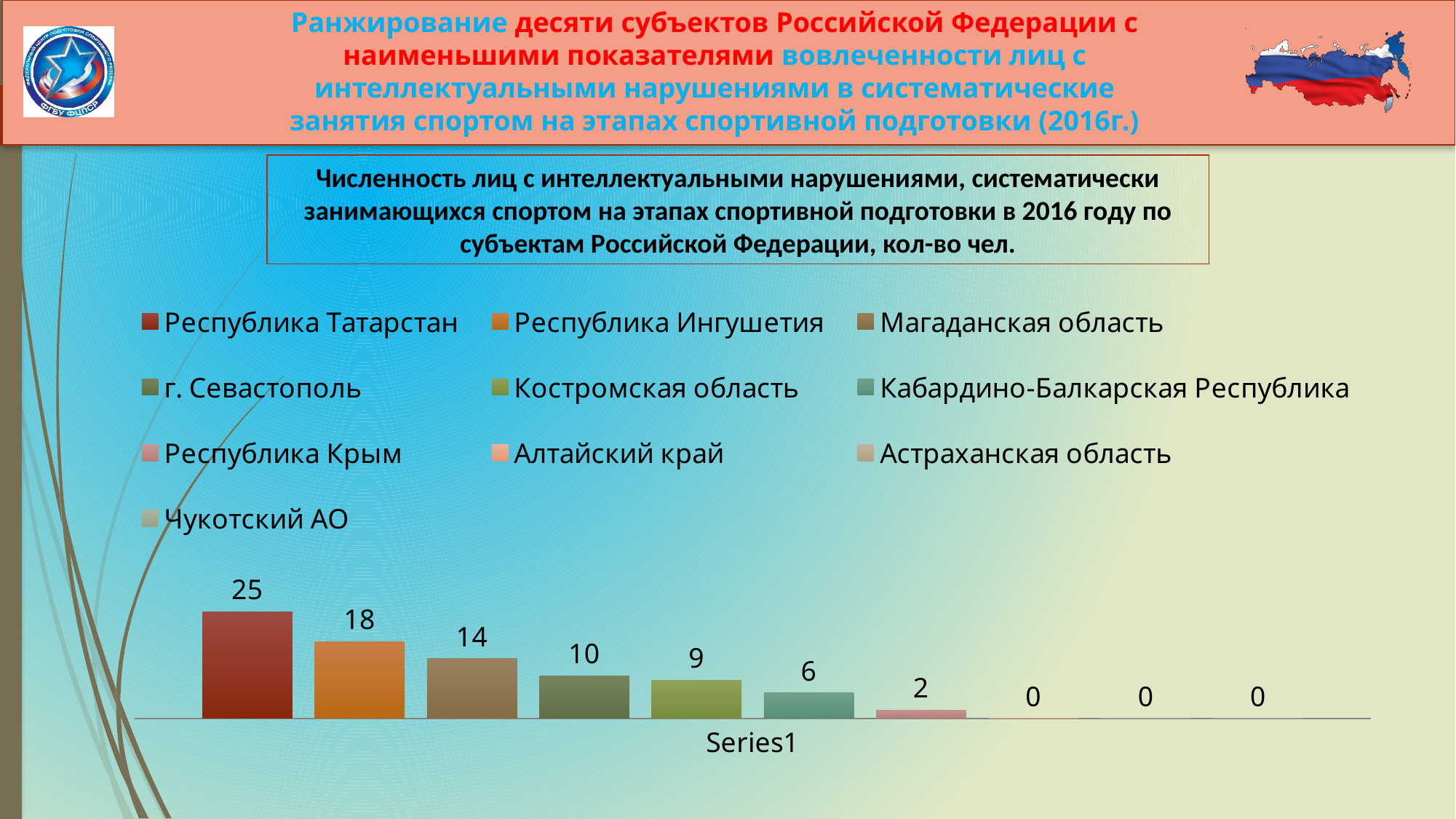
What is the difference between the values for Республика Татарстан and Республика Ингушетия? 7 How many regions have a value of 0 on the chart? 3 What is the value for Республика Татарстан? 25 Which is larger, the value for Магаданская область or the value for Костромская область? Магаданская область What kind of chart is shown on the slide? Bar chart What is the value for Магаданская область? 14 How many series does the legend list? 10 What is the value for Республика Ингушетия? 18 Which region has the highest value on the chart? Республика Татарстан What is the value for Костромская область? 9 What is the difference between the values for г. Севастополь and Кабардино-Балкарская Республика? 4 What is the value for Республика Крым? 2